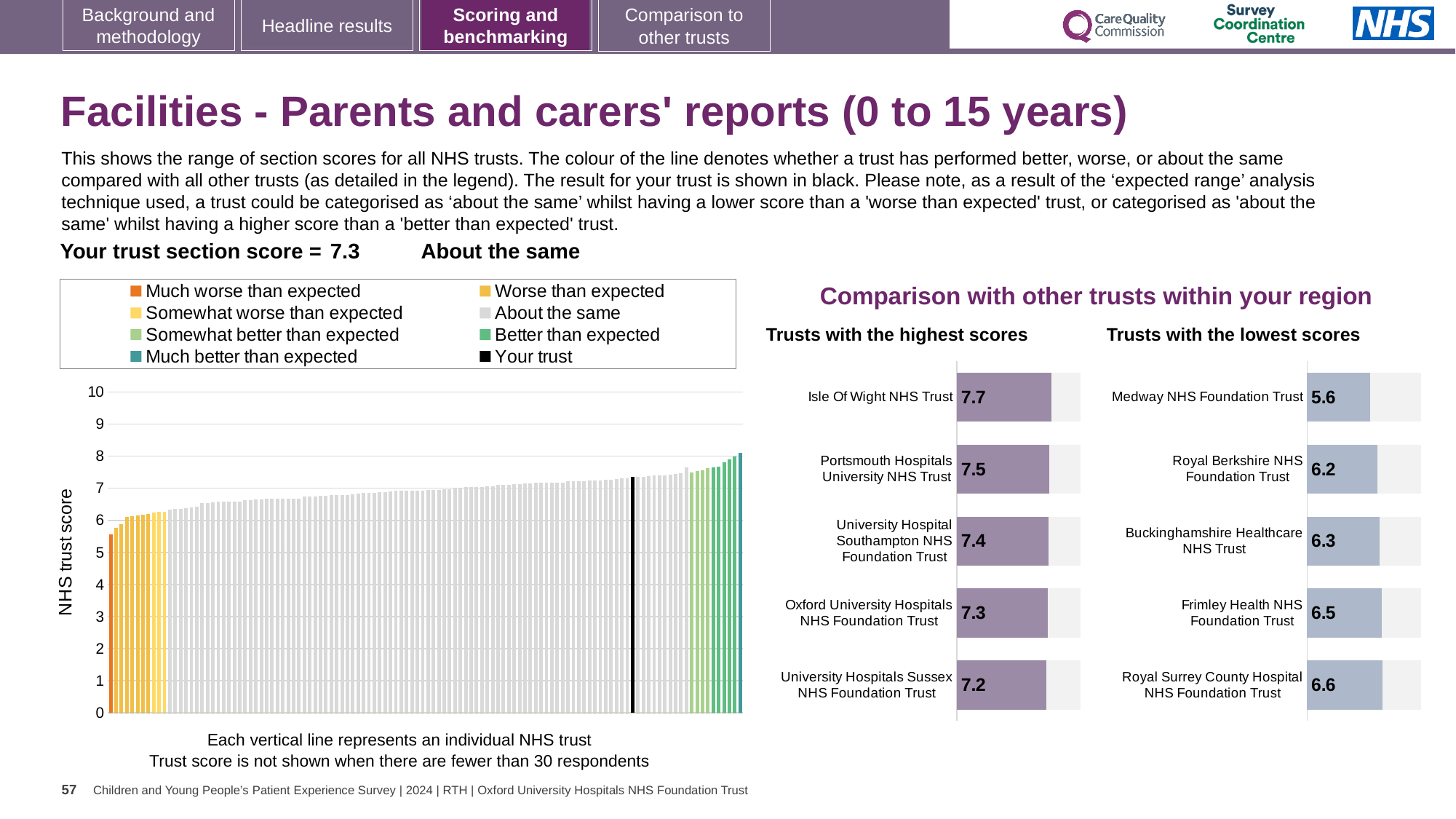
In the 'Trusts with the highest scores' chart, what is the score for University Hospital Southampton NHS Foundation Trust? 7.4 In the main chart on the left showing all NHS trusts, is the value of the black bar (your trust) greater or less than 7? greater In the 'Trusts with the highest scores' chart, what is the score for Isle Of Wight NHS Trust? 7.7 In the 'Trusts with the lowest scores' chart, which has the larger score: Royal Berkshire NHS Foundation Trust or Frimley Health NHS Foundation Trust? Frimley Health NHS Foundation Trust What kind of chart is the main chart on the left showing all NHS trusts? Bar chart In the 'Trusts with the lowest scores' chart, which trust has the lowest score? Medway NHS Foundation Trust In the 'Trusts with the lowest scores' chart, what is the score for Frimley Health NHS Foundation Trust? 6.5 In the 'Trusts with the lowest scores' chart, what is the score for Medway NHS Foundation Trust? 5.6 In the 'Trusts with the highest scores' chart, what is the difference between the scores of Isle Of Wight NHS Trust and University Hospitals Sussex NHS Foundation Trust? 0.5 In the 'Trusts with the highest scores' chart, which trust has the highest score? Isle Of Wight NHS Trust How many entries does the legend above the main chart on the left list? 8 How many trusts are shown in the 'Trusts with the lowest scores' chart? 5